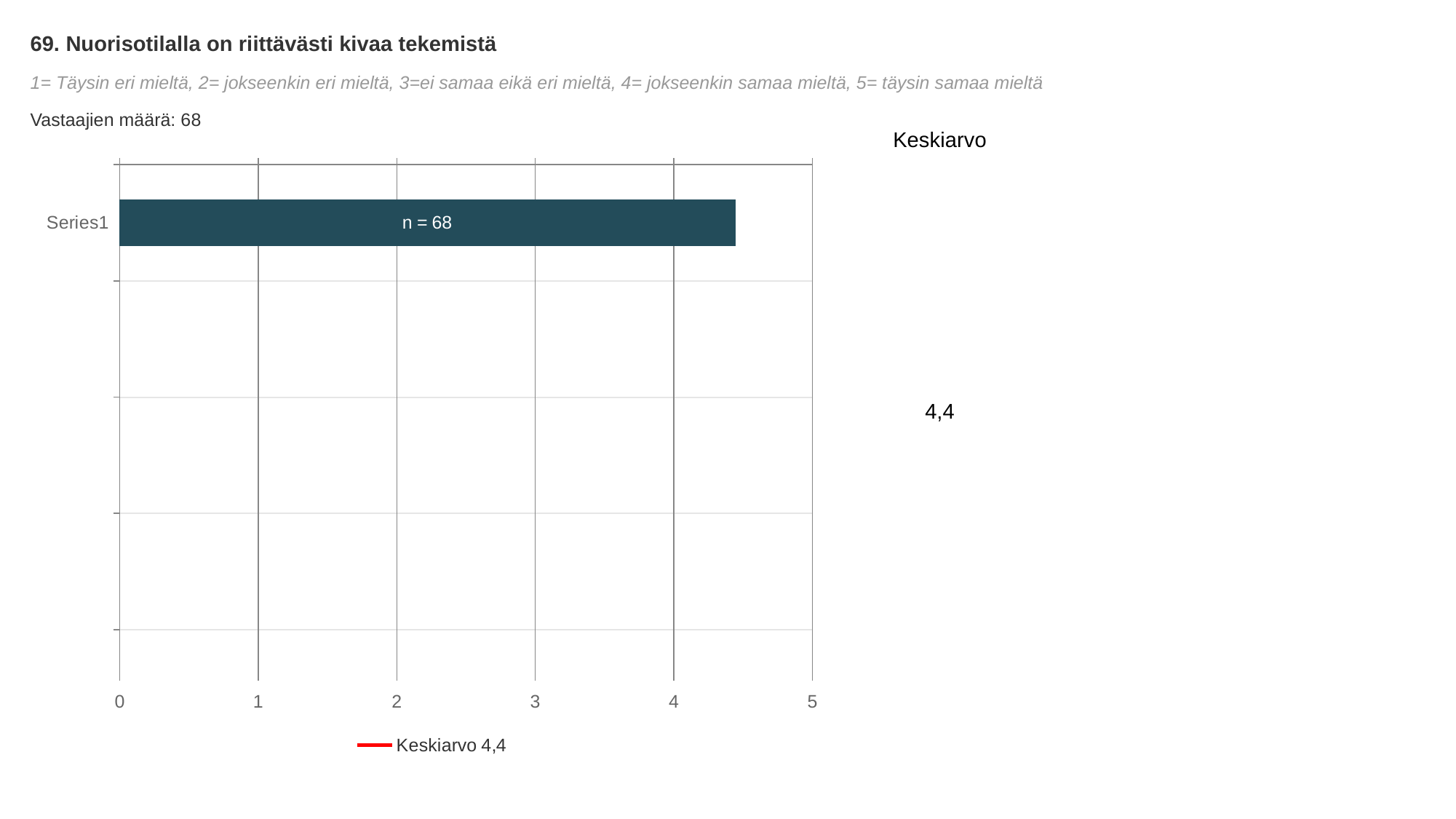
Is the value for Series1 greater or less than 4? greater What is the label of the only category on the y axis? Series1 How many bars are plotted in the chart? 1 What is the highest value shown on the x axis? 5 What data label is printed on the Series1 bar? n = 68 How many entries does the chart legend list? 1 What is the Keskiarvo (mean) value shown for the chart? 4,4 Is the value for Series1 greater or less than 3? greater What is the title of the chart on the slide? 69. Nuorisotilalla on riittävästi kivaa tekemistä What kind of chart is shown on the slide? bar chart Is the value for Series1 greater or less than 5? less